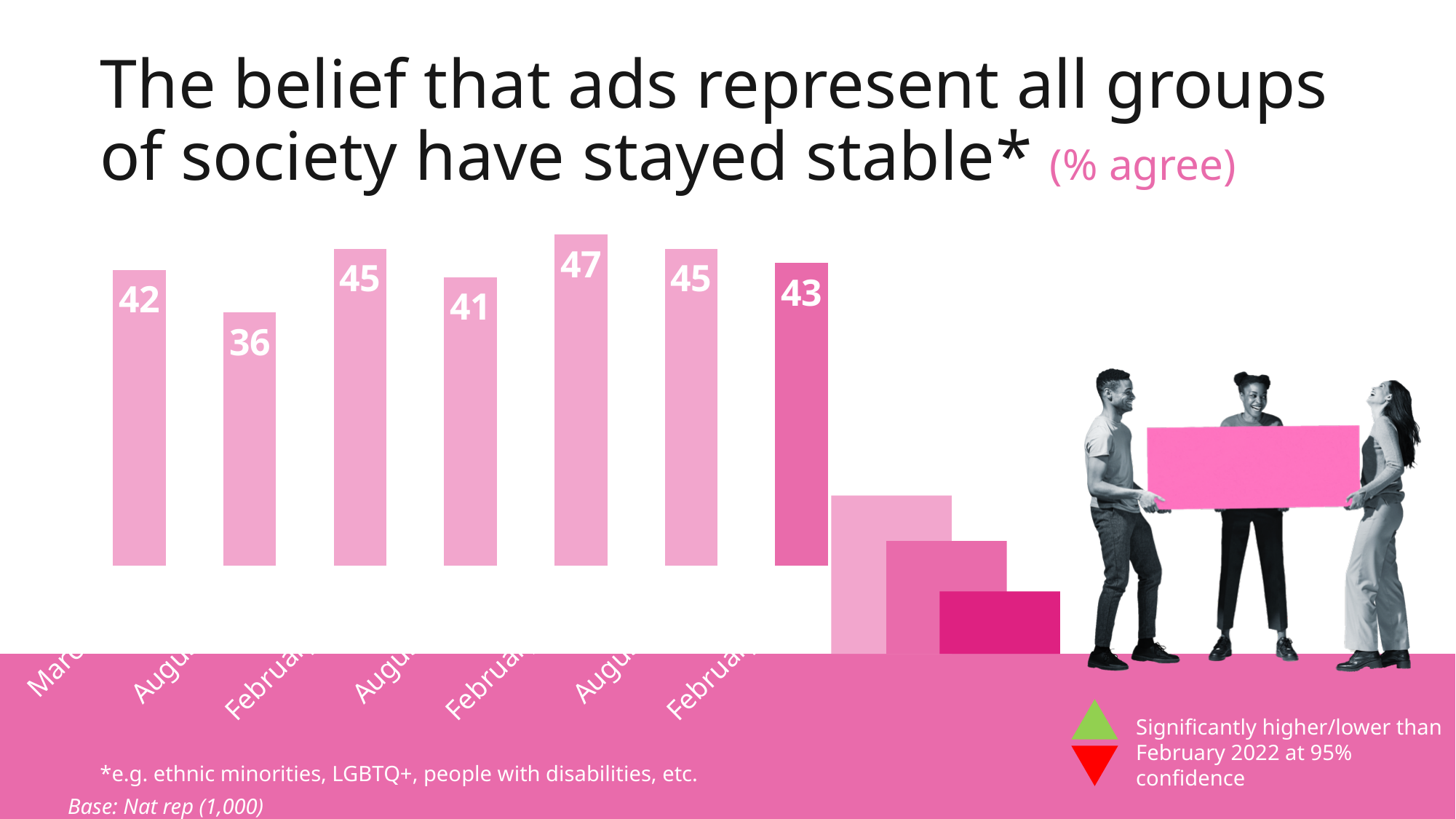
By how much does the last bar's value exceed the first bar's value? 1 What is the highest value shown on any bar in the chart? 47 How many bars are plotted in the chart? 7 What is the difference between the highest bar value and the lowest bar value in the chart? 11 What is the value of the first (leftmost) bar in the chart? 42 What is the lowest value shown on any bar in the chart? 36 What unit is indicated in pink next to the slide title for the chart values? % agree What is the value of the last (rightmost, darker pink) bar in the chart? 43 What is the value of the third bar from the left in the chart? 45 Which bar in the chart is shaded a darker pink than the others? the last (rightmost) bar Which is larger, the value of the first bar or the value of the second bar? the first bar What kind of chart is shown on the slide? bar chart